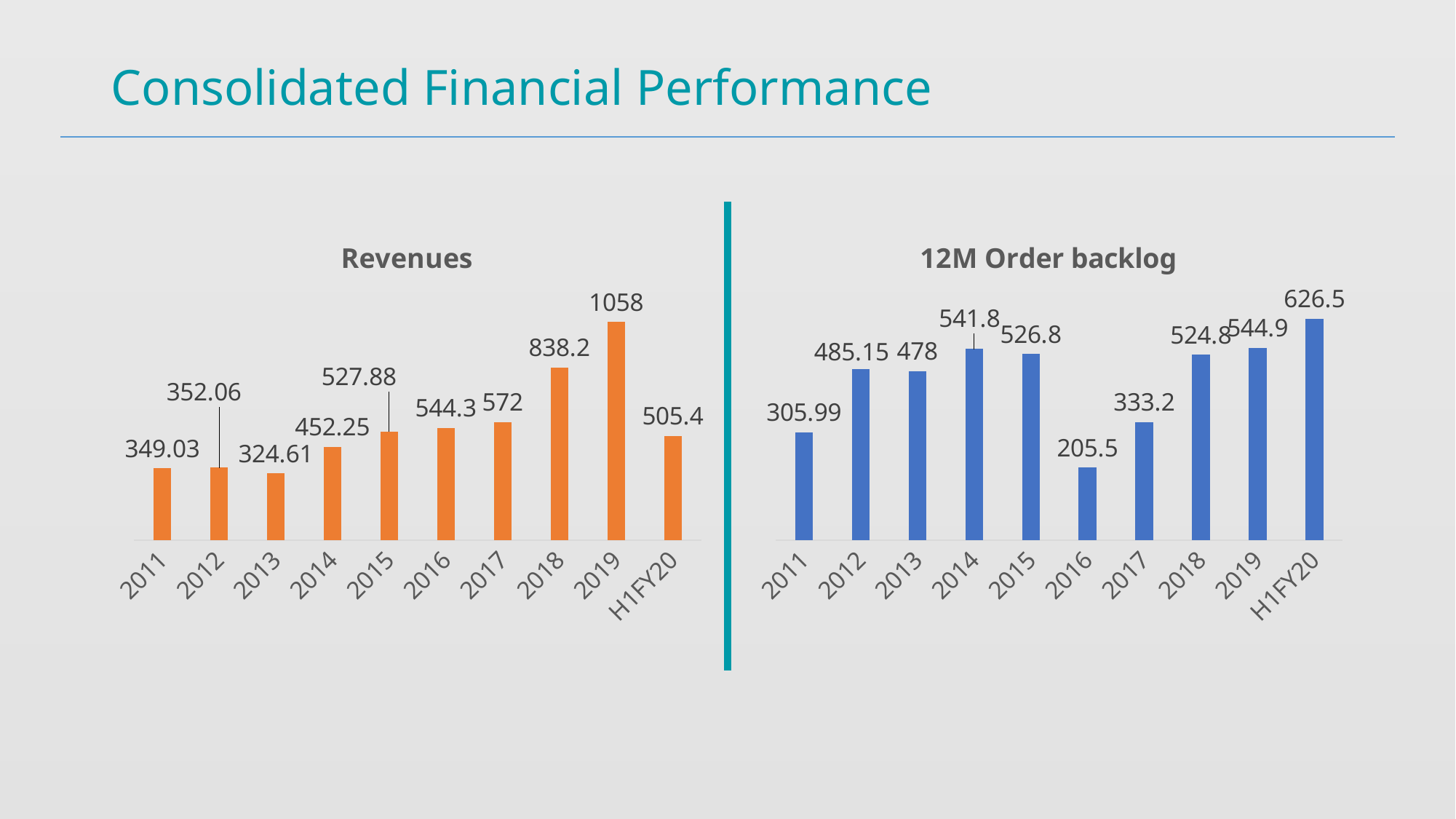
In the Revenues chart, which year has the highest value? 2019 What kind of chart is the 12M Order backlog chart? Bar chart In the Revenues chart, which year has the lowest value? 2013 How many categories are shown on the x axis of the Revenues chart? 10 In the 12M Order backlog chart, which category has the lowest value? 2016 In the Revenues chart, what is the difference between the 2019 and 2018 values? 219.8 In the 12M Order backlog chart, what is the value for H1FY20? 626.5 In the 12M Order backlog chart, which is larger, the value for 2014 or the value for 2015? 2014 In the 12M Order backlog chart, which category has the highest value? H1FY20 In the 12M Order backlog chart, what is the value for 2016? 205.5 In the Revenues chart, what is the value for 2013? 324.61 In the Revenues chart, what is the value for 2019? 1058